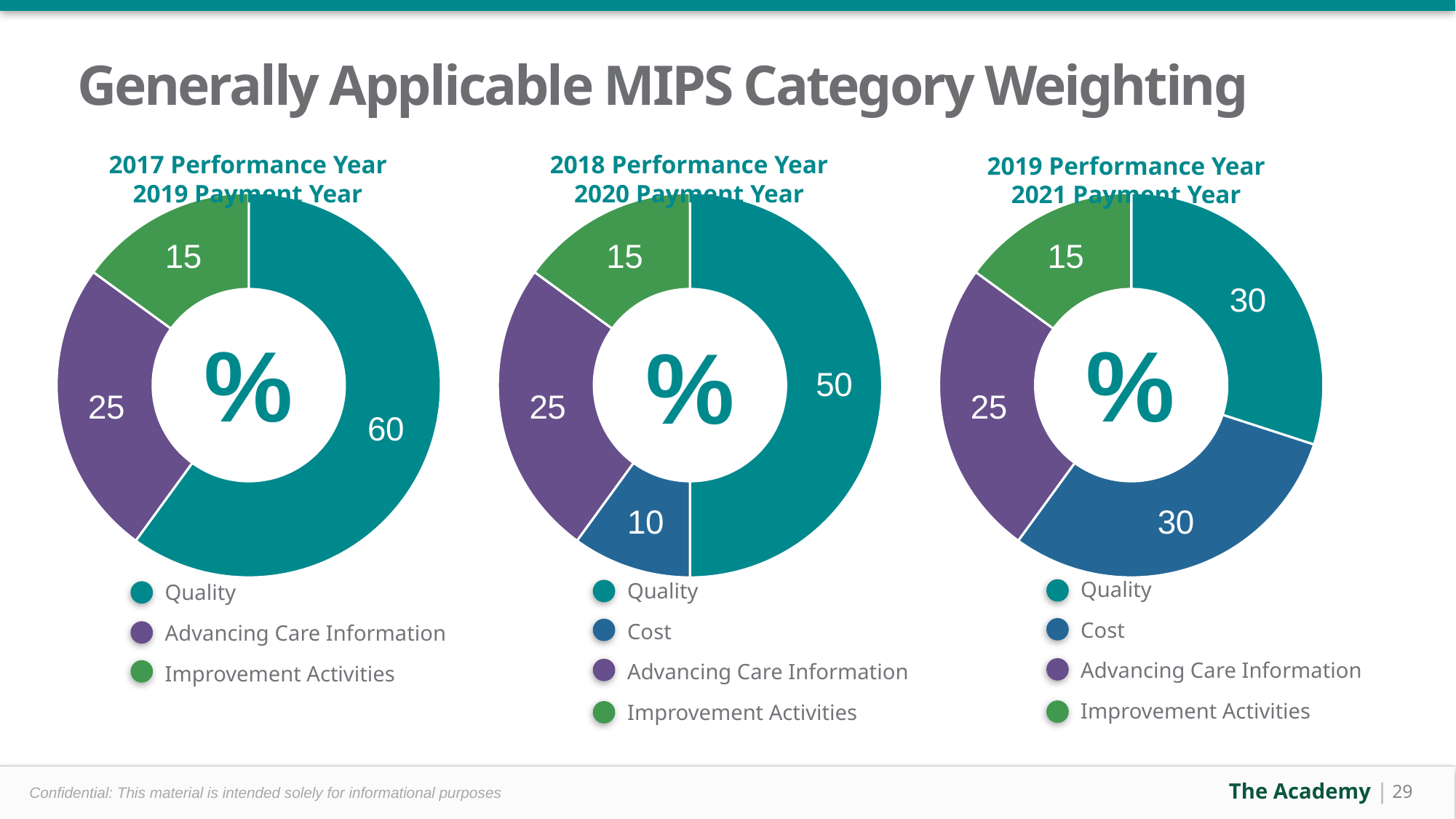
What kind of chart is the 2018 Performance Year chart? Doughnut chart How many categories does the 2019 Performance Year chart show? 4 In the 2018 Performance Year chart, what is the value for Cost? 10 In the 2018 Performance Year chart, which category has the highest value? Quality In the 2019 Performance Year chart, what share of the total does Quality represent? 30% How many categories does the 2017 Performance Year chart show? 3 What is the title of the slide? Generally Applicable MIPS Category Weighting In the 2017 Performance Year chart, what is the value for Quality? 60 In the 2019 Performance Year chart, which category has the lowest value? Improvement Activities In the 2019 Performance Year chart, what is the value for Advancing Care Information? 25 In the 2017 Performance Year chart, what is the difference between Quality and Advancing Care Information? 35 In the 2018 Performance Year chart, which is larger, Advancing Care Information or Improvement Activities? Advancing Care Information